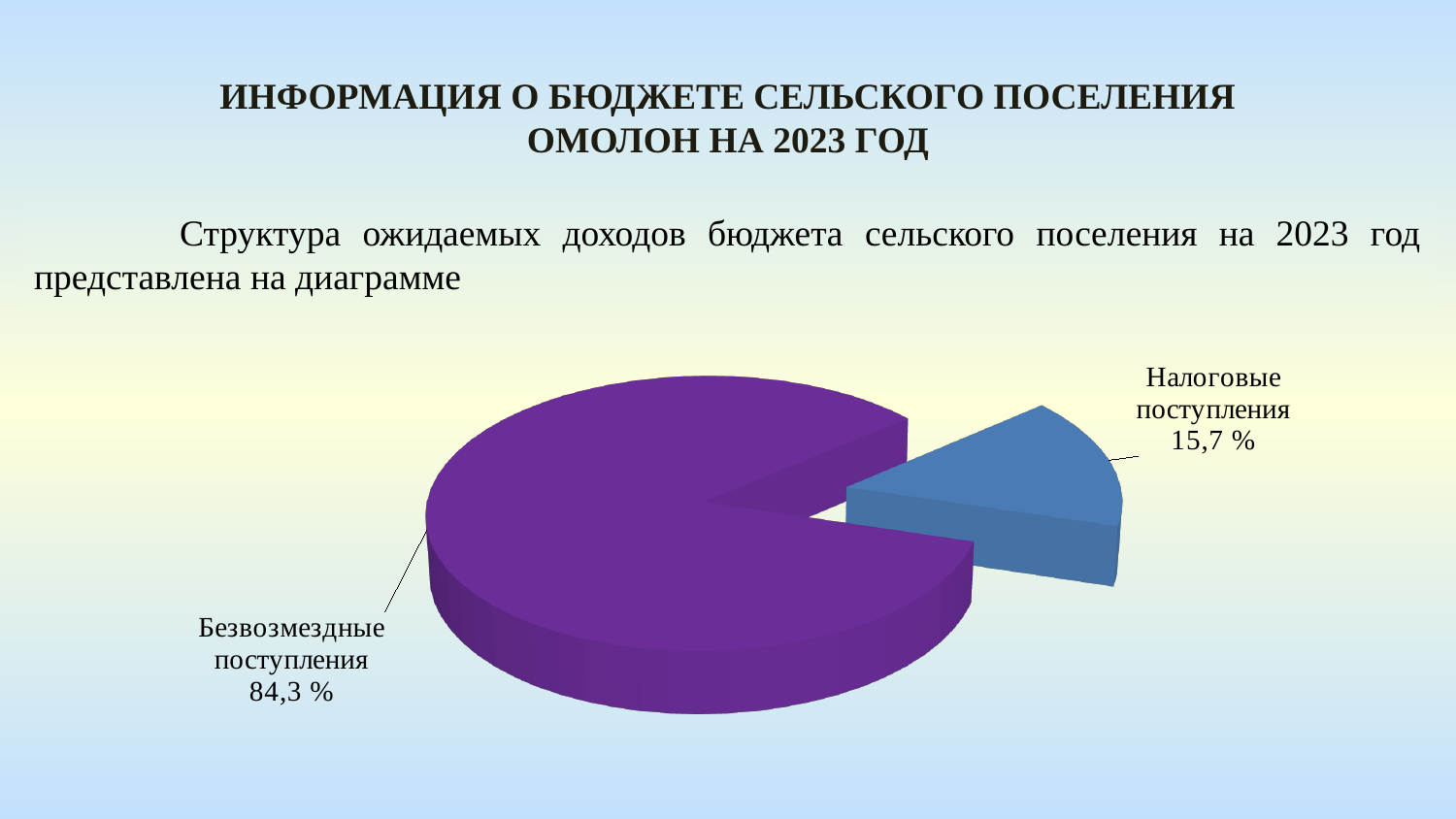
Is the share for "Налоговые поступления" greater or less than 20%? less What colour is the "Безвозмездные поступления" slice? Purple Which is larger: the "Налоговые поступления" slice or the "Безвозмездные поступления" slice? Безвозмездные поступления Which slice of the pie is the smallest? Налоговые поступления What colour is the "Налоговые поступления" slice? Blue What share of the pie is labelled "Безвозмездные поступления"? 84,3 % What kind of chart is shown on the slide? Pie chart How many slices does the pie chart have? 2 Is the share for "Безвозмездные поступления" greater or less than 80%? greater What share of the pie is labelled "Налоговые поступления"? 15,7 % Which slice of the pie is the largest? Безвозмездные поступления What is the difference in percentage points between the "Безвозмездные поступления" and "Налоговые поступления" slices? 68,6